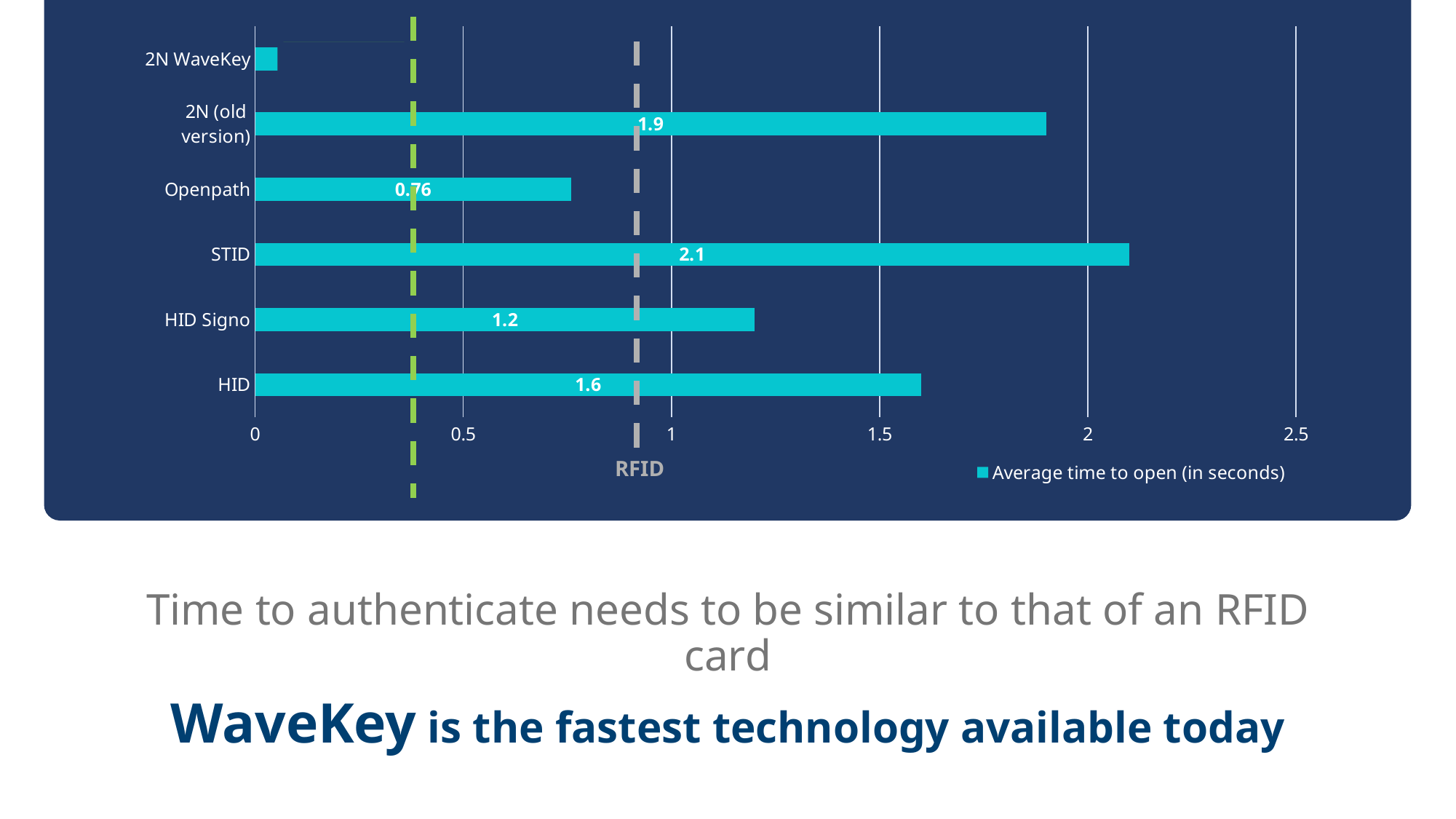
Is the value for 2N WaveKey greater or less than 0.5? less What is the legend entry for the series in the chart? Average time to open (in seconds) Which has a larger average time to open, HID or 2N (old version)? 2N (old version) What is the average time to open for 2N (old version)? 1.9 What is the difference between the average time to open for STID and HID Signo? 0.9 Which category has the lowest average time to open? 2N WaveKey What is the average time to open for STID? 2.1 Which category has the highest average time to open? STID What is the average time to open for Openpath? 0.76 What is the average time to open for HID Signo? 1.2 How many categories are shown in the chart? 6 What kind of chart is shown on the slide? bar chart